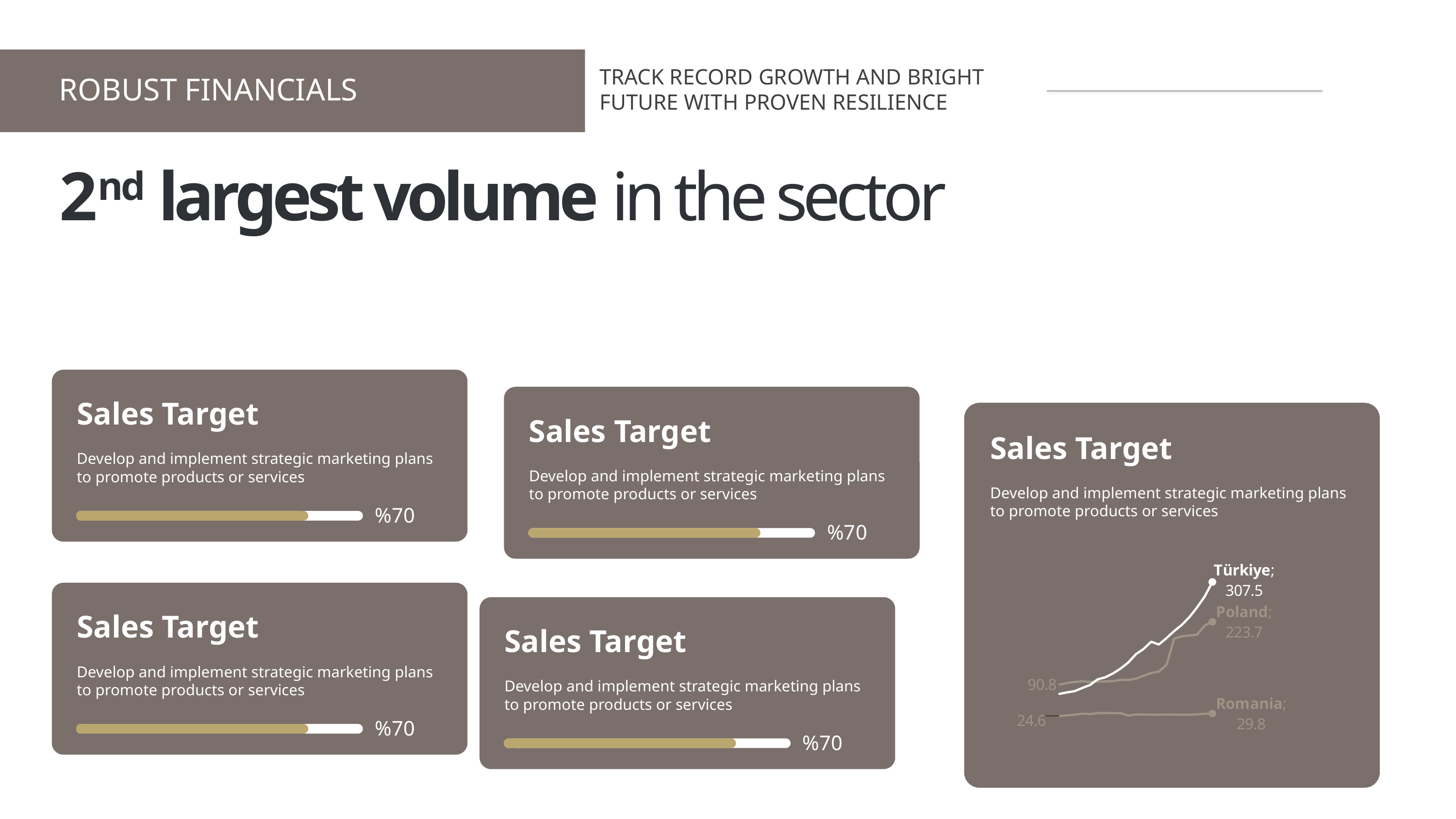
In the line chart, what is the difference between the final values of Türkiye and Poland? 83.8 In the line chart, does the Türkiye line rise or fall from left to right? rises In the line chart, what is the final value labelled for Poland? 223.7 In the line chart, what is the difference between the final values of Poland and Romania? 193.9 In the line chart, which has the larger final value, Poland or Romania? Poland In the line chart, what is the final value labelled for Türkiye? 307.5 How many series (countries) are plotted in the line chart on the bottom right? 3 In the line chart, what is the starting value labelled at the left end of the Romania line? 24.6 What kind of chart is shown in the bottom-right 'Sales Target' card? line chart In the line chart, what is the final value labelled for Romania? 29.8 In the line chart, which country has the highest final value? Türkiye In the line chart, which country has the lowest final value? Romania